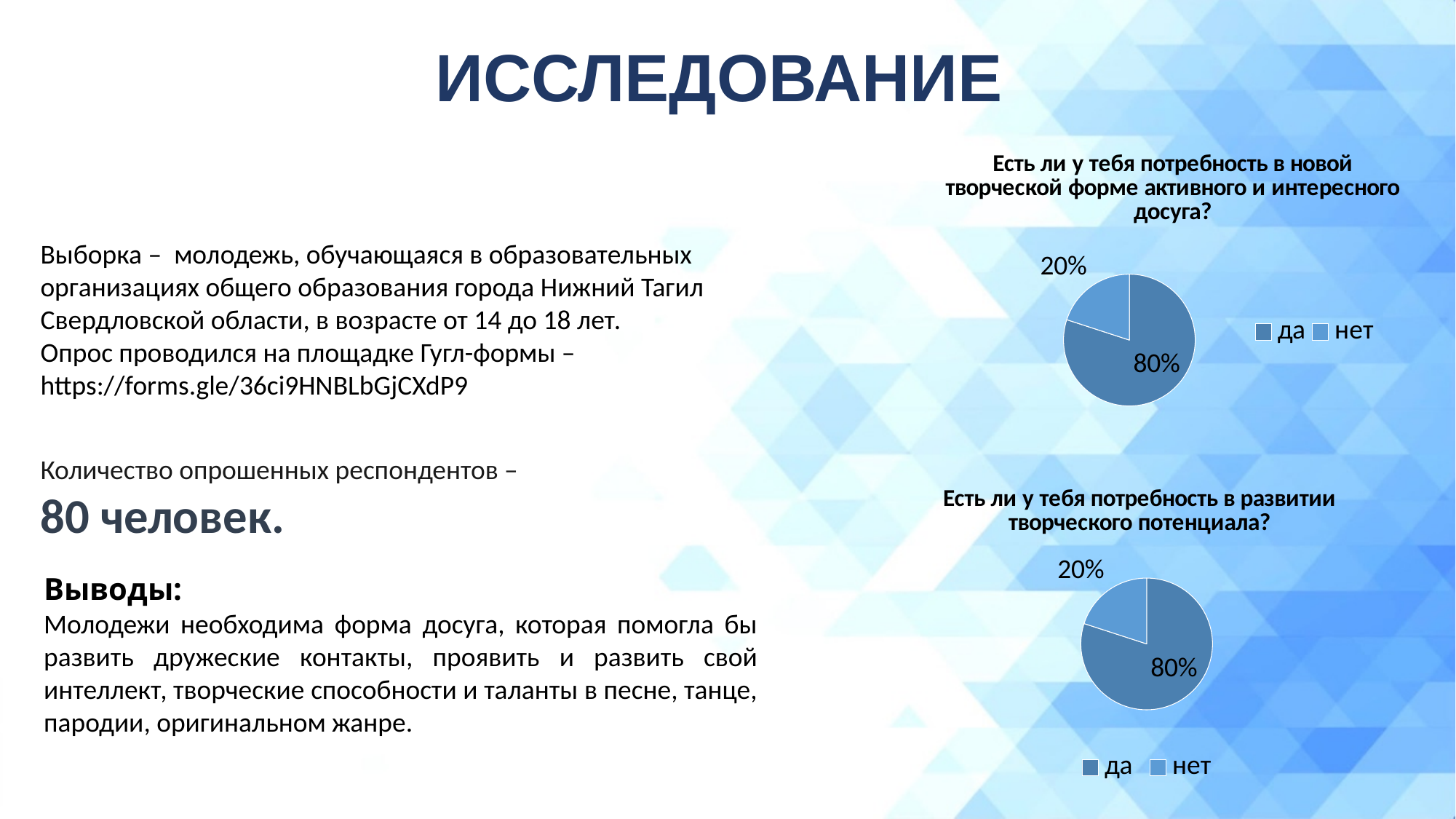
In the top chart titled "Есть ли у тебя потребность в новой творческой форме активного и интересного досуга?", what share of respondents answered "нет"? 20% In the top chart on the slide, what is the difference in percentage points between the "да" and "нет" slices? 60 In the bottom chart on the slide, which answer has the smallest slice? нет In the bottom chart titled "Есть ли у тебя потребность в развитии творческого потенциала?", what share of respondents answered "нет"? 20% How many slices does the bottom pie chart on the slide have? 2 In the top chart titled "Есть ли у тебя потребность в новой творческой форме активного и интересного досуга?", what share of respondents answered "да"? 80% What type of chart is the top chart on the slide? Pie chart How many entries does the legend of the top chart on the slide list? 2 In the bottom chart titled "Есть ли у тебя потребность в развитии творческого потенциала?", what share of respondents answered "да"? 80% In the top chart on the slide, which answer has the largest slice? да What is the title of the bottom chart on the slide? Есть ли у тебя потребность в развитии творческого потенциала? In the bottom chart on the slide, which slice is larger, "да" or "нет"? да